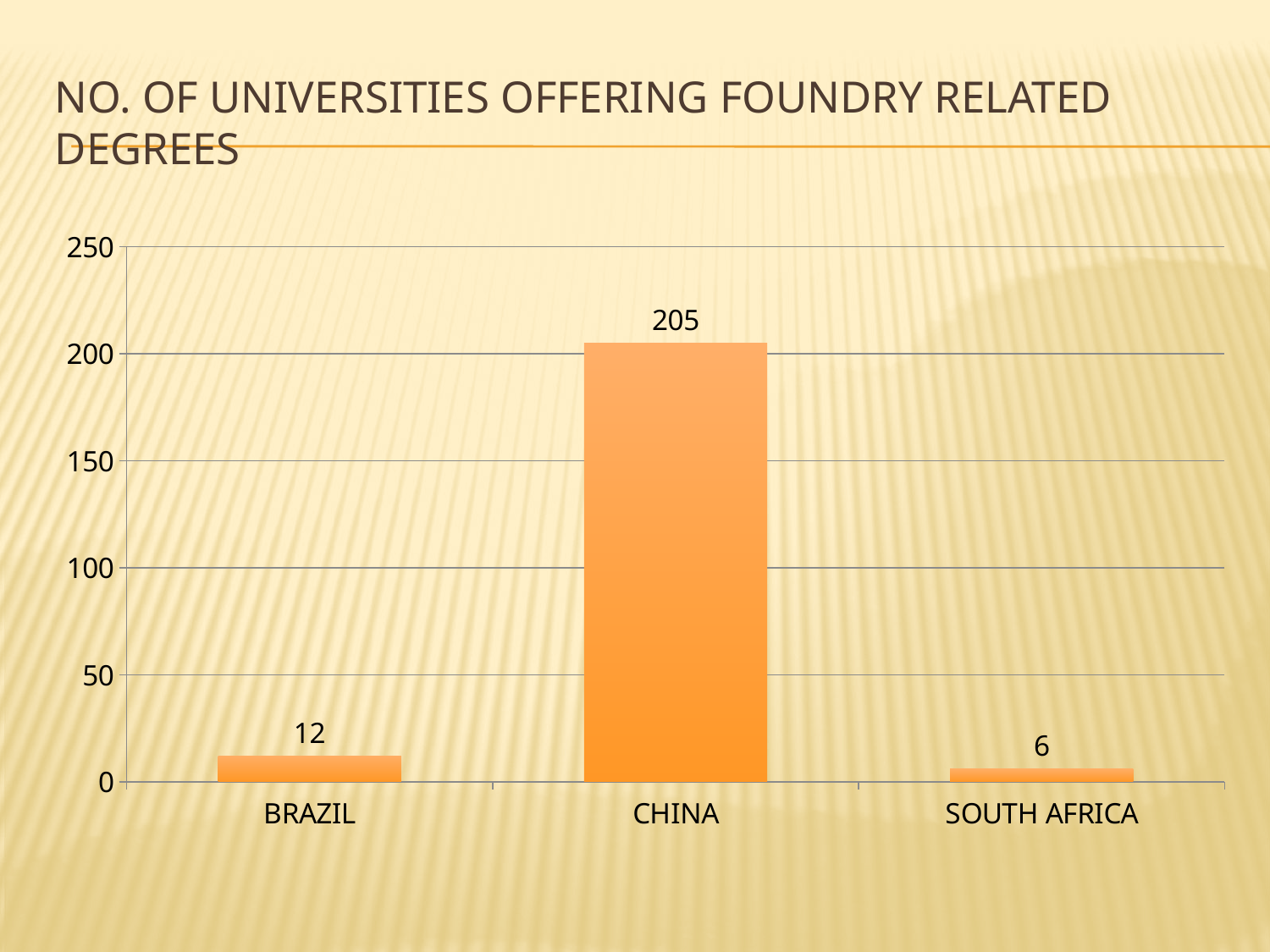
What is the value for Brazil? 12 Which country has the lowest number of universities offering foundry related degrees? South Africa What kind of chart is shown on the slide? bar chart Which country has the highest number of universities offering foundry related degrees? China How many countries are shown on the chart? 3 What is the difference between the values for China and Brazil? 193 What is the value for South Africa? 6 What is the title of the slide? NO. OF UNIVERSITIES OFFERING FOUNDRY RELATED DEGREES Which is larger, the value for Brazil or the value for South Africa? Brazil What is the value for China? 205 What is the difference between the values for Brazil and South Africa? 6 Is the value for China greater or less than 200? greater